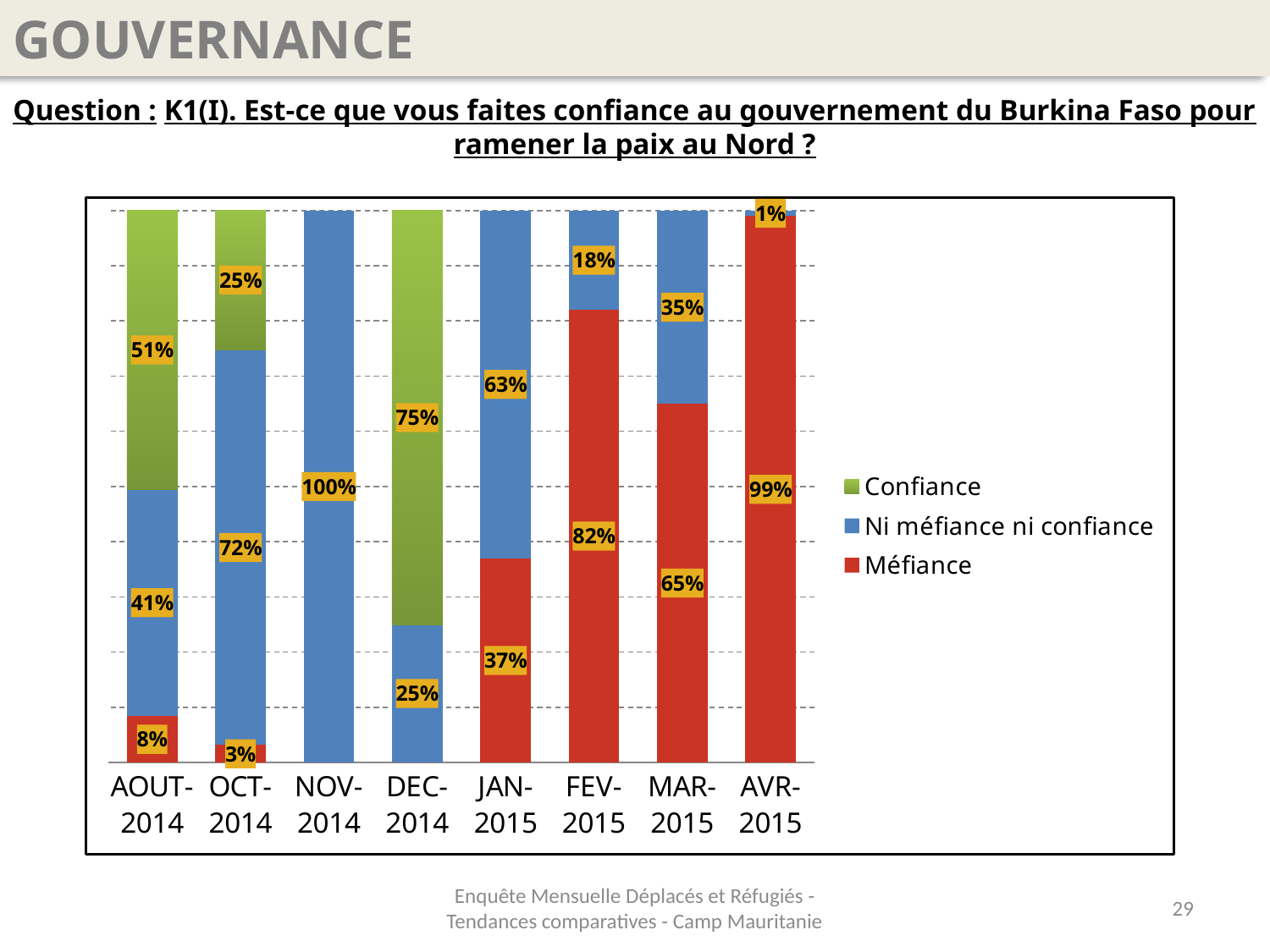
What is the value of Confiance for DEC-2014? 75% In which month is Méfiance highest? AVR-2015 Which is larger: Ni méfiance ni confiance in JAN-2015 or Ni méfiance ni confiance in OCT-2014? OCT-2014 What kind of chart is shown on the slide? stacked bar chart In which month is Confiance highest? DEC-2014 What is the value of Méfiance for OCT-2014? 3% What is the value of Ni méfiance ni confiance for NOV-2014? 100% How many series does the legend list? 3 What is the value of Méfiance for AVR-2015? 99% How many months (categories) are shown on the x axis? 8 What is the difference between Méfiance in FEV-2015 and Méfiance in MAR-2015? 17% Which series is shown in red in the legend? Méfiance